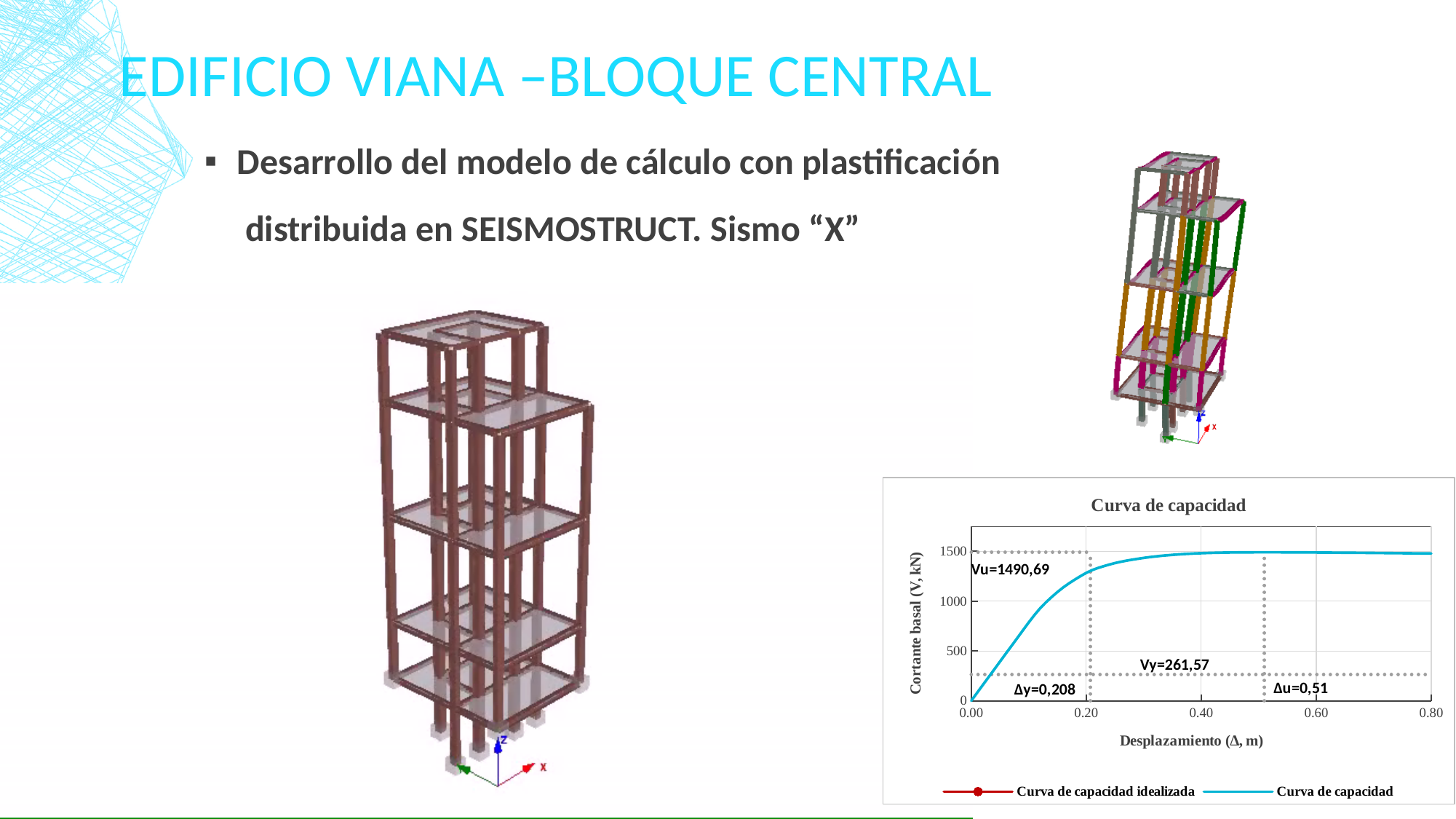
In the 'Curva de capacidad' chart, how does the base shear change as displacement increases along the x axis? It rises and then levels off In the 'Curva de capacidad' chart, what value is given for Δy? 0,208 In the 'Curva de capacidad' chart, what value is given for Vy? 261,57 What kind of chart is the 'Curva de capacidad' chart? line chart In the 'Curva de capacidad' chart, is the base shear at a displacement of 0.40 m greater or less than 1000? greater In the 'Curva de capacidad' chart, what value is given for Δu? 0,51 What are the two legend entries of the 'Curva de capacidad' chart? Curva de capacidad idealizada; Curva de capacidad In the 'Curva de capacidad' chart, what value is given for Vu? 1490,69 In the 'Curva de capacidad' chart, what is the difference between Vu and Vy? 1229,12 What is the title of the chart on the slide? Curva de capacidad How many series does the legend of the 'Curva de capacidad' chart list? 2 In the 'Curva de capacidad' chart, which is larger, Vu or Vy? Vu